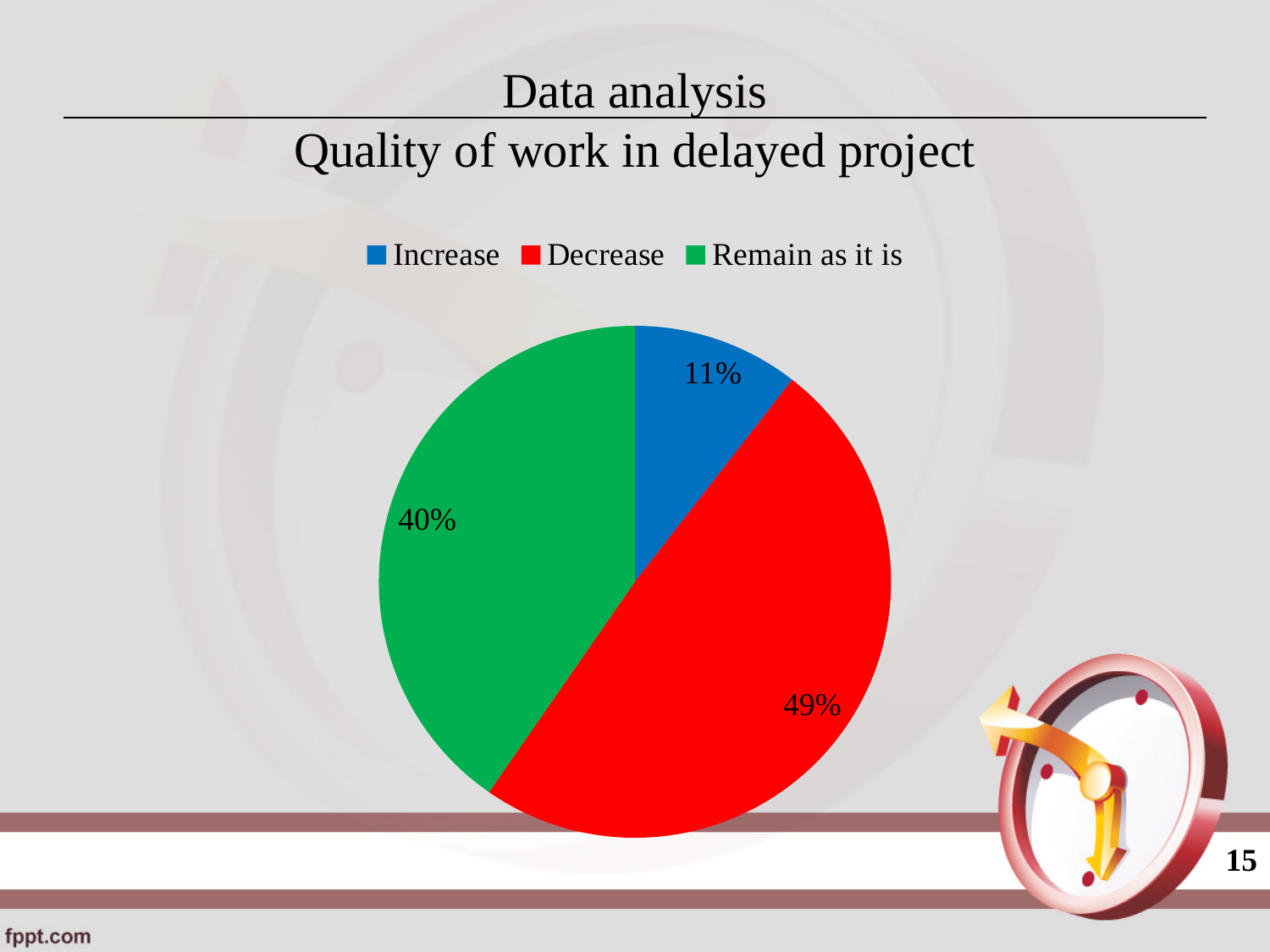
How many slices does the pie chart have? 3 What kind of chart is shown on the slide? pie chart Which is larger, the Remain as it is slice or the Increase slice? Remain as it is What percentage of the pie is labelled for Remain as it is? 40% What is the difference in percentage points between the Decrease slice and the Remain as it is slice? 9 What percentage of the pie is labelled for Increase? 11% Which category has the smallest slice of the pie? Increase What colour is the Decrease slice? red How many entries does the legend list? 3 What percentage of the pie is labelled for Decrease? 49% Which category has the largest slice of the pie? Decrease What is the difference in percentage points between the Decrease slice and the Increase slice? 38